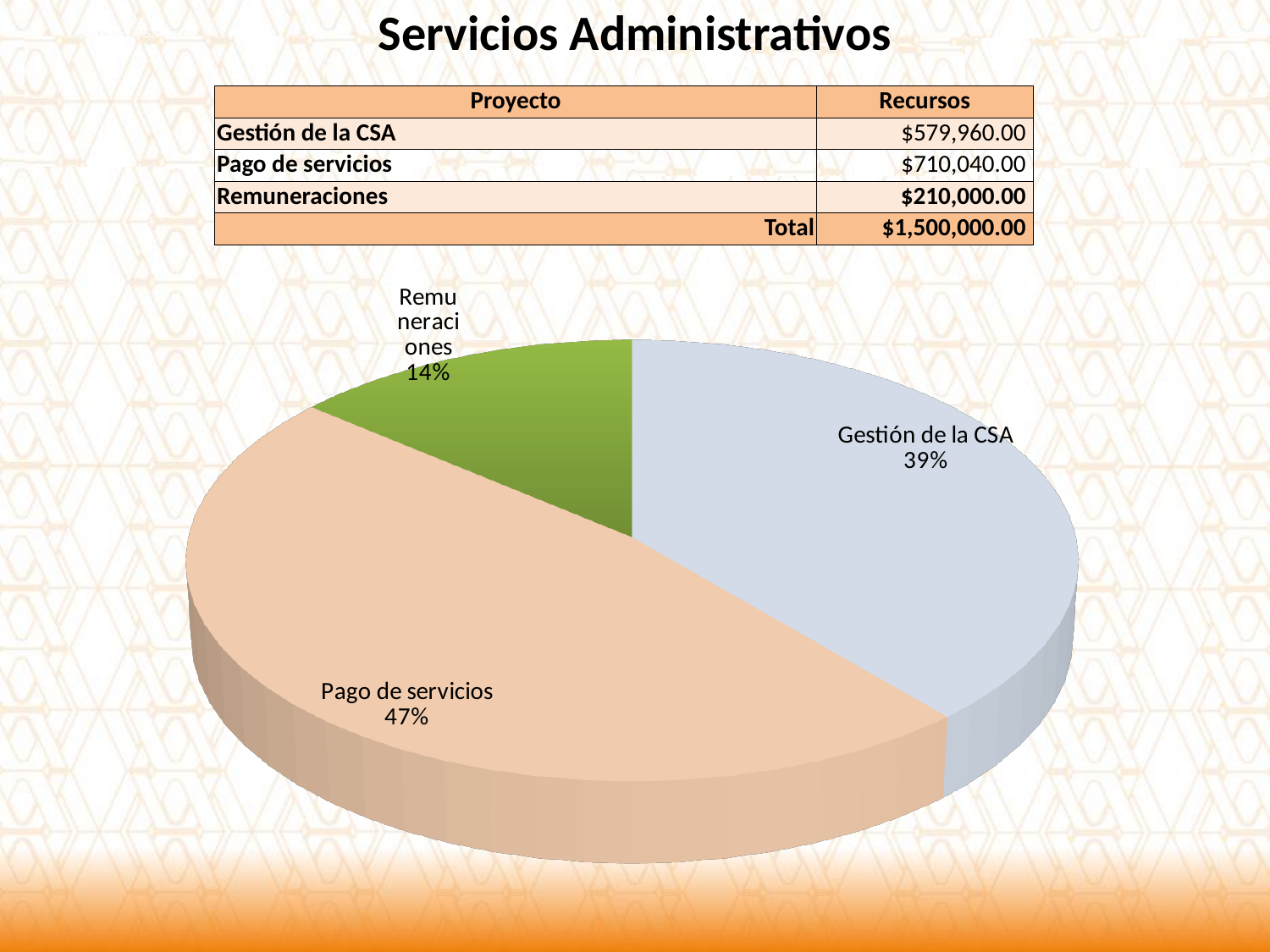
What is the title shown at the top of the slide above the chart? Servicios Administrativos What share of the pie does Gestión de la CSA represent? 39% What is the difference in percentage points between the Gestión de la CSA slice and the Remuneraciones slice? 25 Which is larger, the share for Gestión de la CSA or the share for Remuneraciones? Gestión de la CSA What is the difference in percentage points between the Pago de servicios slice and the Gestión de la CSA slice? 8 Which category has the largest slice of the pie? Pago de servicios What kind of chart is shown on the slide? Pie chart Which category has the smallest slice of the pie? Remuneraciones What share of the pie does Remuneraciones represent? 14% How many slices does the pie chart have? 3 What colour is the Remuneraciones slice of the pie? Green What share of the pie does Pago de servicios represent? 47%